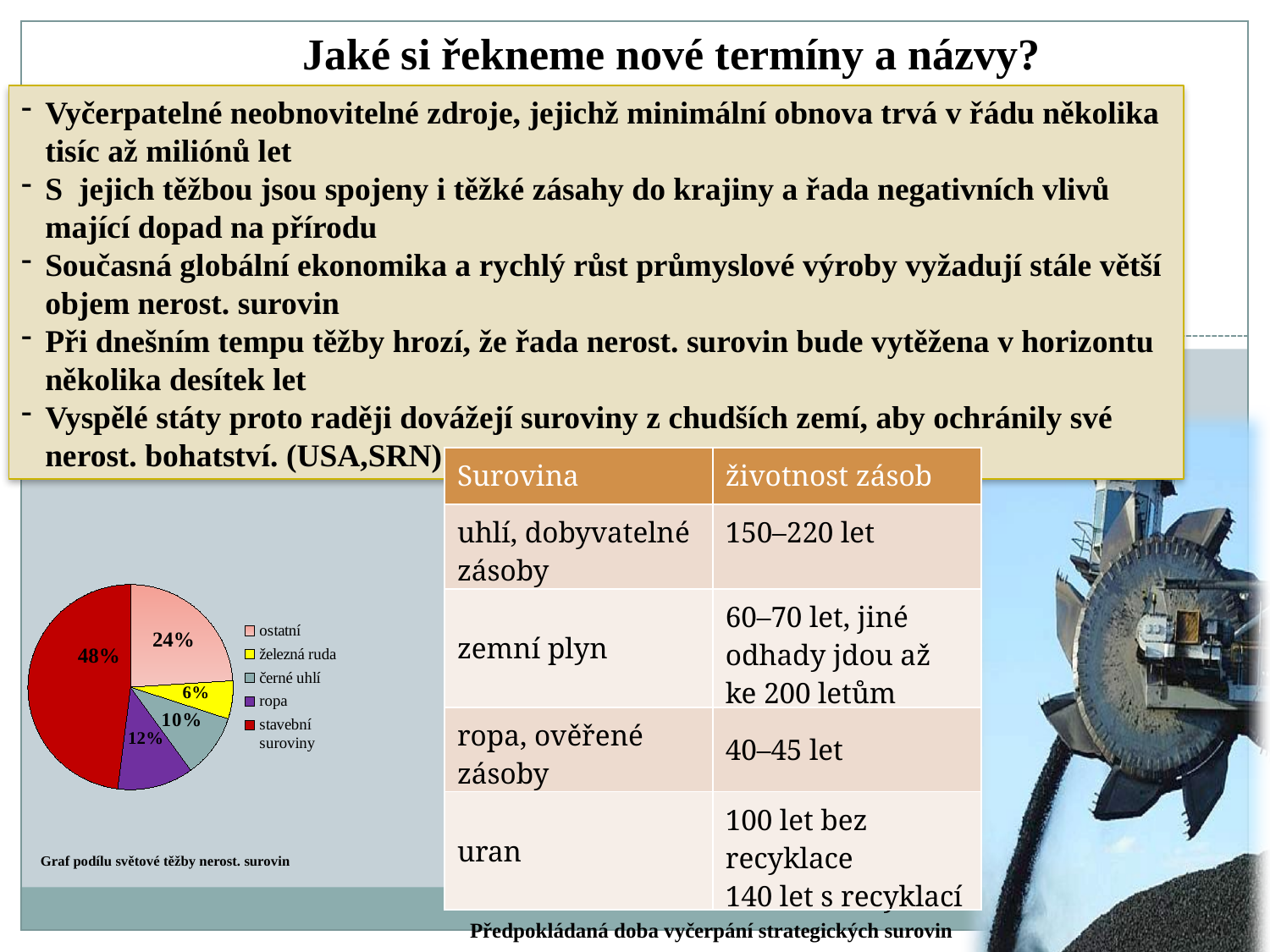
What share of the pie chart does 'ropa' represent? 12% Which category has the largest slice in the pie chart? stavební suroviny What colour is the 'ropa' slice in the pie chart? purple Which category has the smallest slice in the pie chart? železná ruda What is the difference in percentage points between 'stavební suroviny' and 'ostatní' in the pie chart? 24 What share of the pie chart does 'stavební suroviny' represent? 48% How many categories does the pie chart show? 5 What share of the pie chart does 'černé uhlí' represent? 10% Which is larger in the pie chart, 'ropa' or 'černé uhlí'? ropa What share of the pie chart does 'ostatní' represent? 24% What type of chart is shown on the slide? pie chart What share of the pie chart does 'železná ruda' represent? 6%